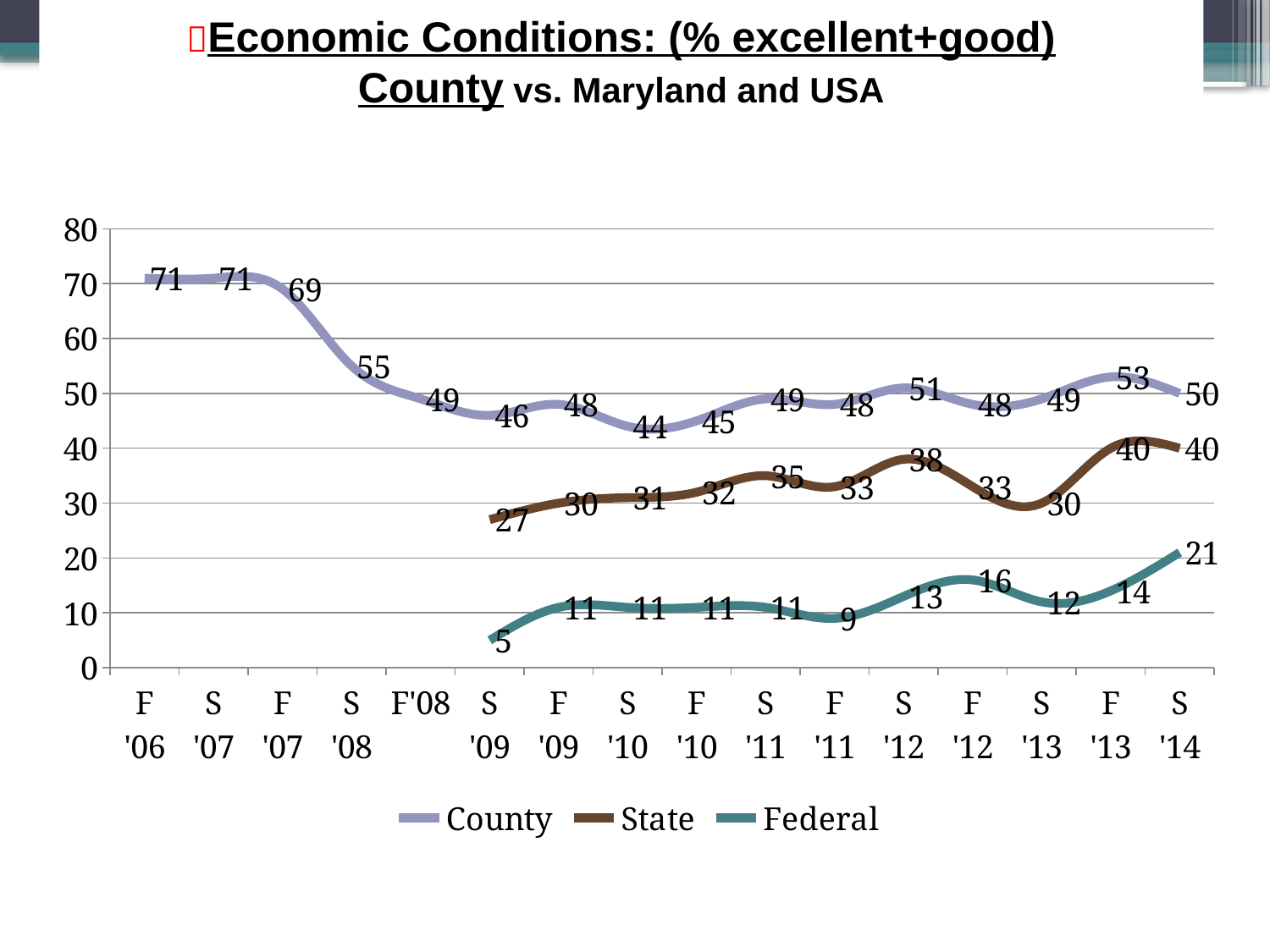
How many series does the legend list? 3 What is the Federal value for S '09? 5 What is the Federal value for F '13? 14 What kind of chart is shown on the slide? line chart What is the difference between the County and State values in S '14? 10 Does the County line rise or fall from F '06 to S '08? fall In which period is the State value lowest? S '09 In which period is the County value lowest? S '10 In which period is the Federal value highest? S '14 What is the State value for S '14? 40 What is the County value for F '06? 71 How many survey periods are shown along the x axis? 16